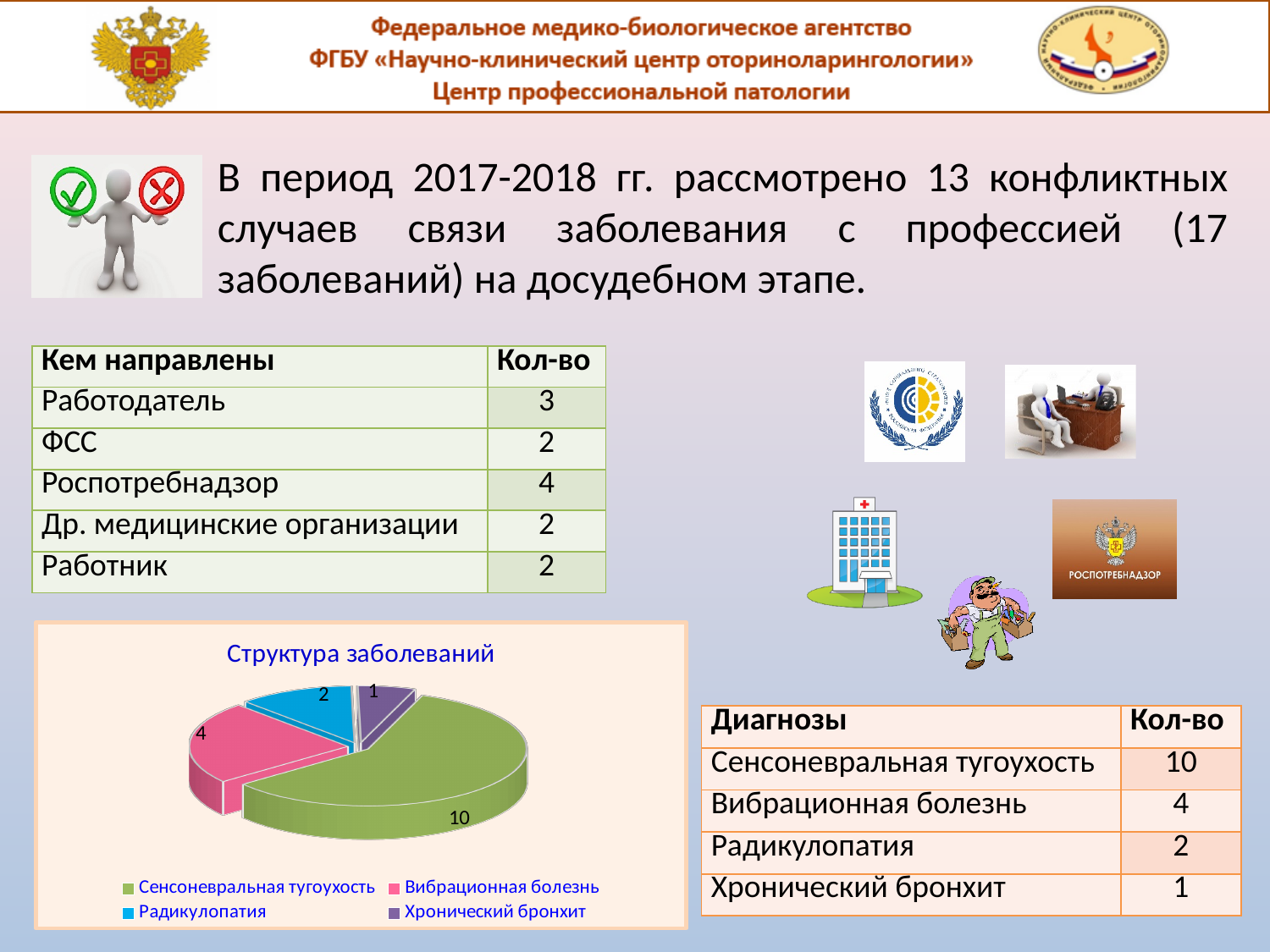
In the pie chart "Структура заболеваний", what is the difference between the values for Сенсоневральная тугоухость and Вибрационная болезнь? 6 What type of chart is shown under the title "Структура заболеваний"? pie chart In the pie chart "Структура заболеваний", what is the value for Хронический бронхит? 1 In the pie chart "Структура заболеваний", which is larger: Вибрационная болезнь or Радикулопатия? Вибрационная болезнь How many entries does the legend of the pie chart "Структура заболеваний" list? 4 Which category has the largest slice in the pie chart "Структура заболеваний"? Сенсоневральная тугоухость In the pie chart "Структура заболеваний", what is the value for Вибрационная болезнь? 4 Which category has the smallest slice in the pie chart "Структура заболеваний"? Хронический бронхит In the pie chart "Структура заболеваний", what is the value for Радикулопатия? 2 How many slices does the pie chart "Структура заболеваний" have? 4 In the pie chart "Структура заболеваний", what is the value for Сенсоневральная тугоухость? 10 What is the title of the pie chart on the slide? Структура заболеваний